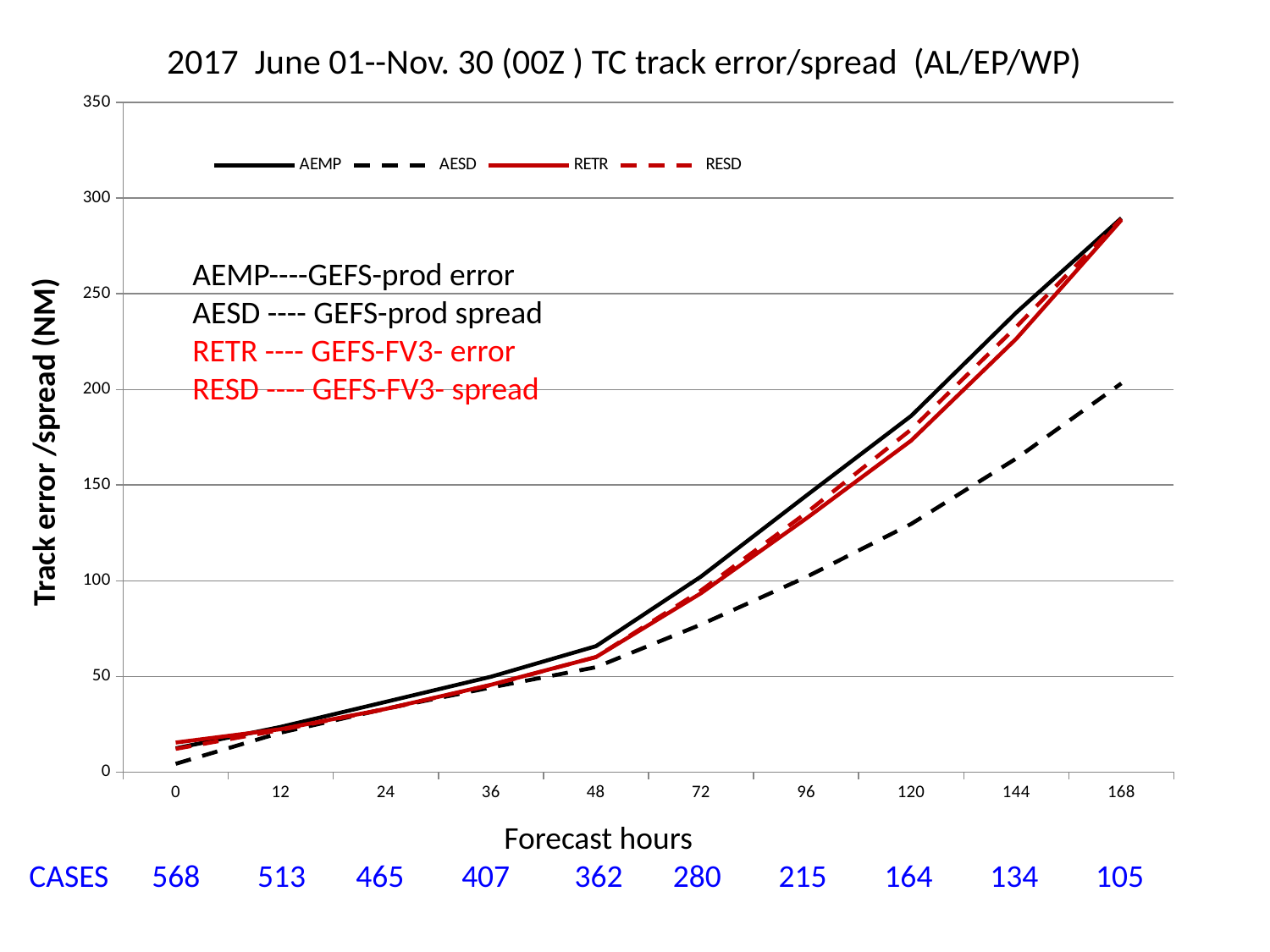
Is the value for AESD at 120 forecast hours greater or less than 150? less Is the value for AEMP at 168 forecast hours greater or less than 250? greater Is the value for RETR at 48 forecast hours greater or less than 100? less How many forecast-hour points are marked along the x axis? 10 What kind of chart is shown on the slide? line chart How many series does the legend list? 4 Which series has the lowest value at 168 forecast hours? AESD At 168 forecast hours, which is larger, AEMP or AESD? AEMP Do the AEMP values rise or fall as forecast hours increase? rise According to the annotation on the chart, what does RETR represent? GEFS-FV3- error